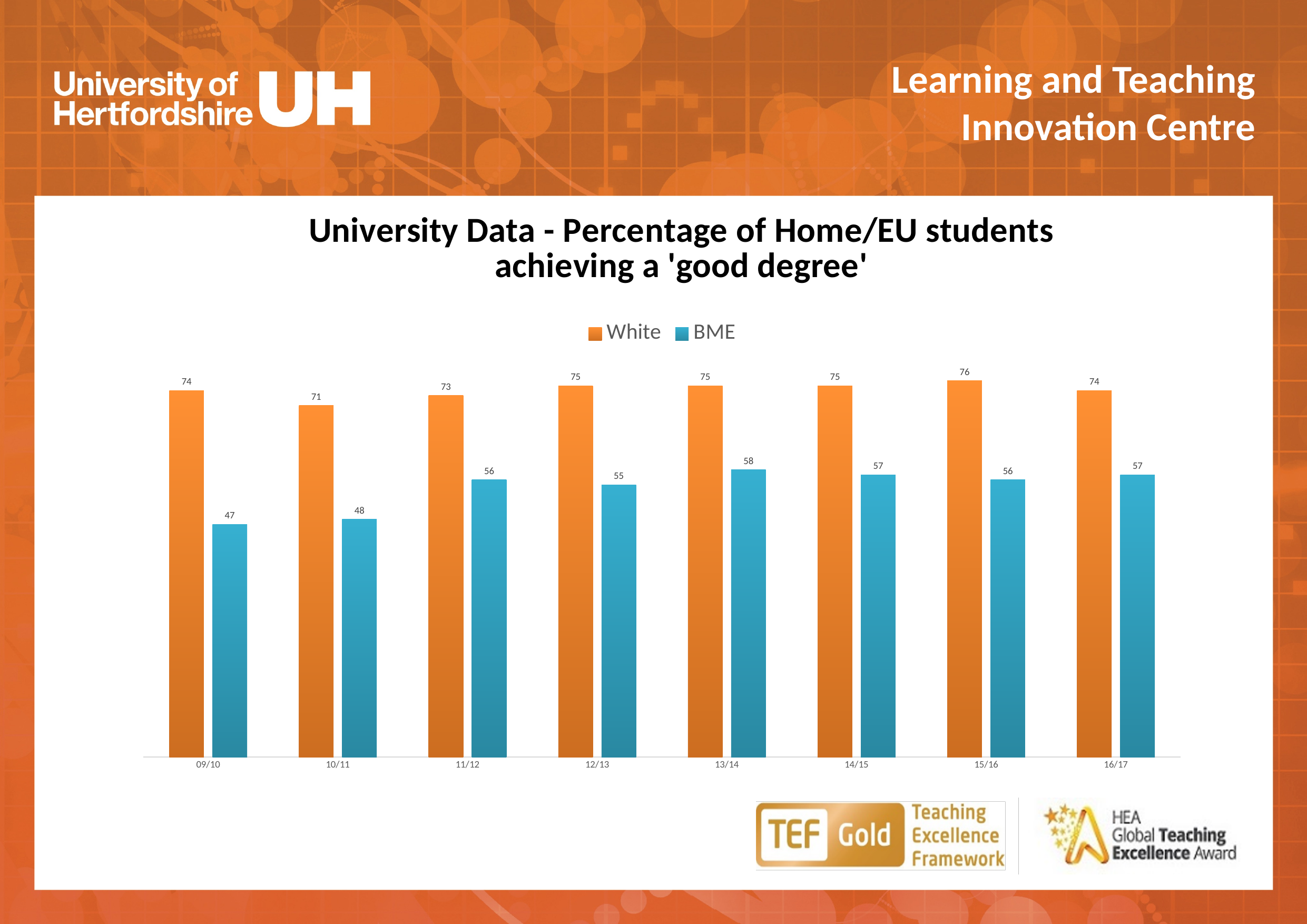
What is the value for BME students in 09/10? 47 What is the difference between the White and BME values in 16/17? 17 In which year is the White series highest? 15/16 How many series does the legend list? 2 What is the value for BME students in 13/14? 58 Which is larger, the BME value in 10/11 or the BME value in 12/13? 12/13 How many years are shown on the x axis? 8 What is the difference between the White and BME values in 09/10? 27 What colour are the bars for the BME series? Blue In which year is the BME series lowest? 09/10 What is the value for White students in 09/10? 74 What kind of chart is shown on the slide? Bar chart